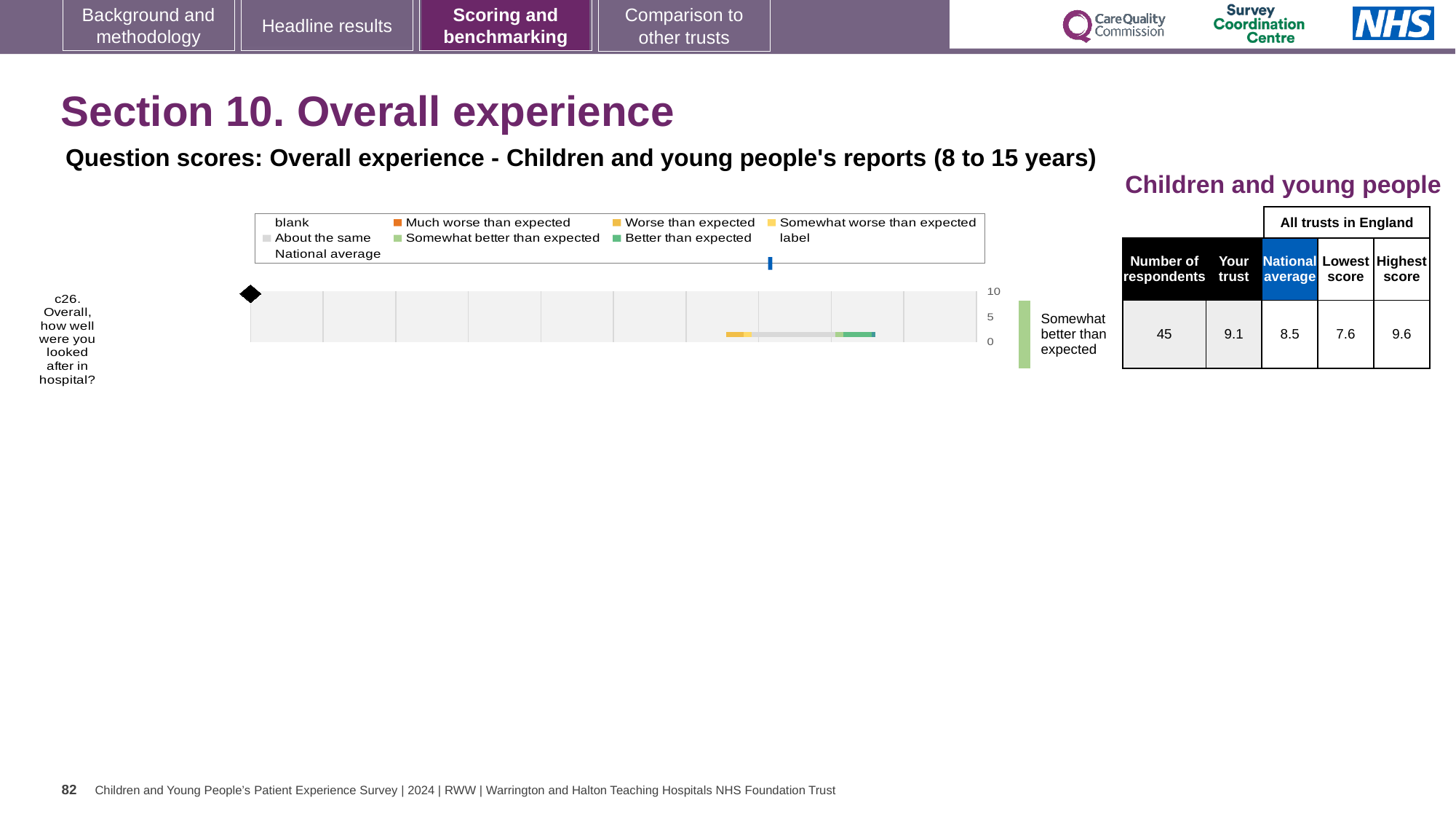
What is the 'Your trust' score for c26? 9.1 How many respondents answered c26? 45 How many survey questions are plotted on the chart? 1 Which question is plotted on the chart? c26. Overall, how well were you looked after in hospital? What is the maximum value shown on the chart's score axis? 10 What is the lowest score across all trusts in England for c26? 7.6 What is the difference between the 'Your trust' score and the national average for c26? 0.6 What is the highest score across all trusts in England for c26? 9.6 What is the national average score for c26? 8.5 Which is larger for c26, the 'Your trust' score or the national average? Your trust What benchmark category is shown next to the bar for c26? Somewhat better than expected What kind of chart is used to show the question score for c26? bar chart